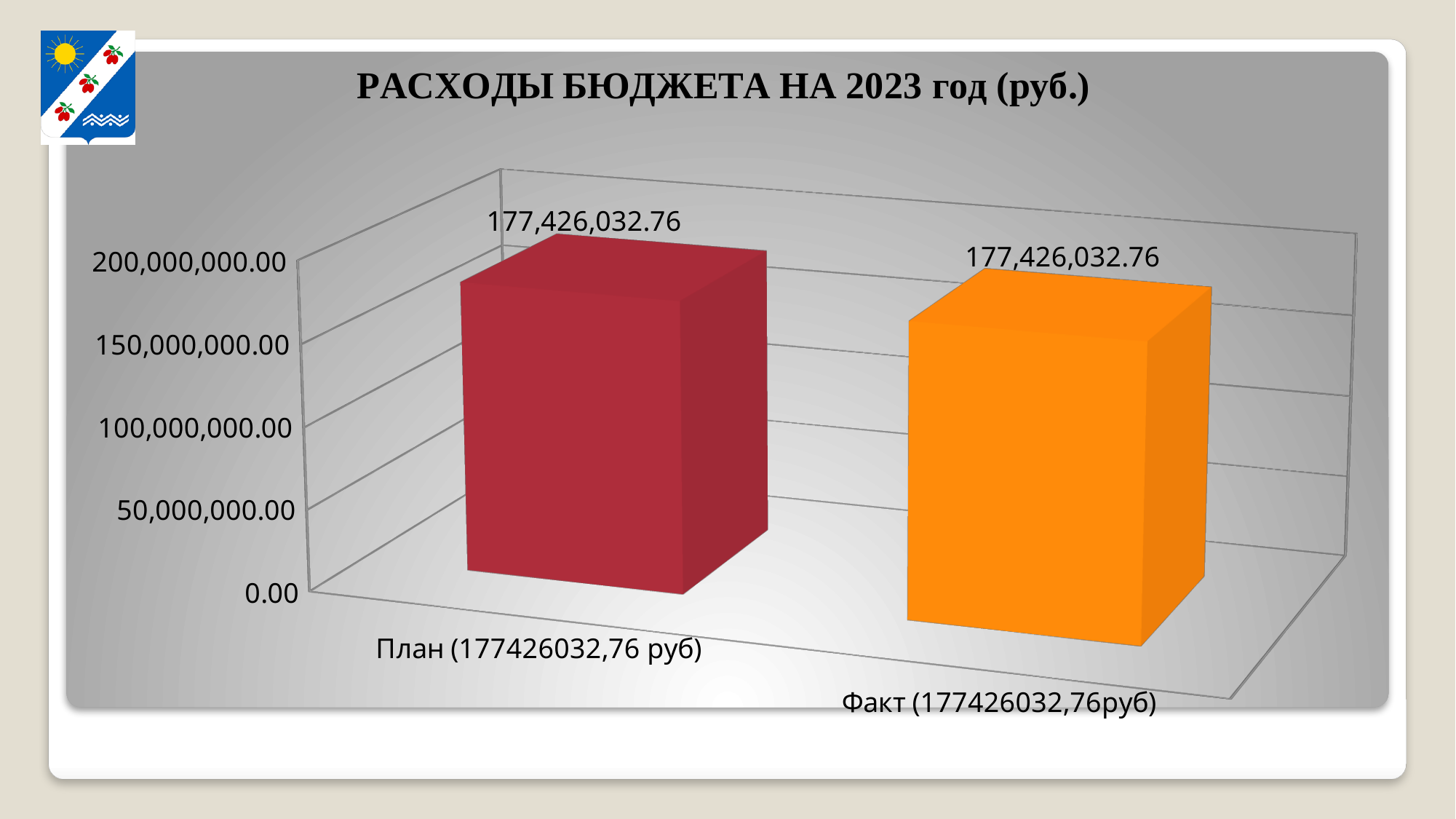
What is the value of the План bar? 177,426,032.76 What is the difference between the План and Факт values? 0.00 What is the highest tick value shown on the vertical axis? 200,000,000.00 How many bars are plotted on the chart? 2 What is the title of the chart? РАСХОДЫ БЮДЖЕТА НА 2023 год (руб.) What colour is the Факт bar? orange What is the value of the Факт bar? 177,426,032.76 Is the value for План larger than, smaller than, or equal to the value for Факт? equal Is the value for Факт greater or less than 150,000,000.00? greater Is the value for План greater or less than 200,000,000.00? less What kind of chart is shown on the slide? bar chart